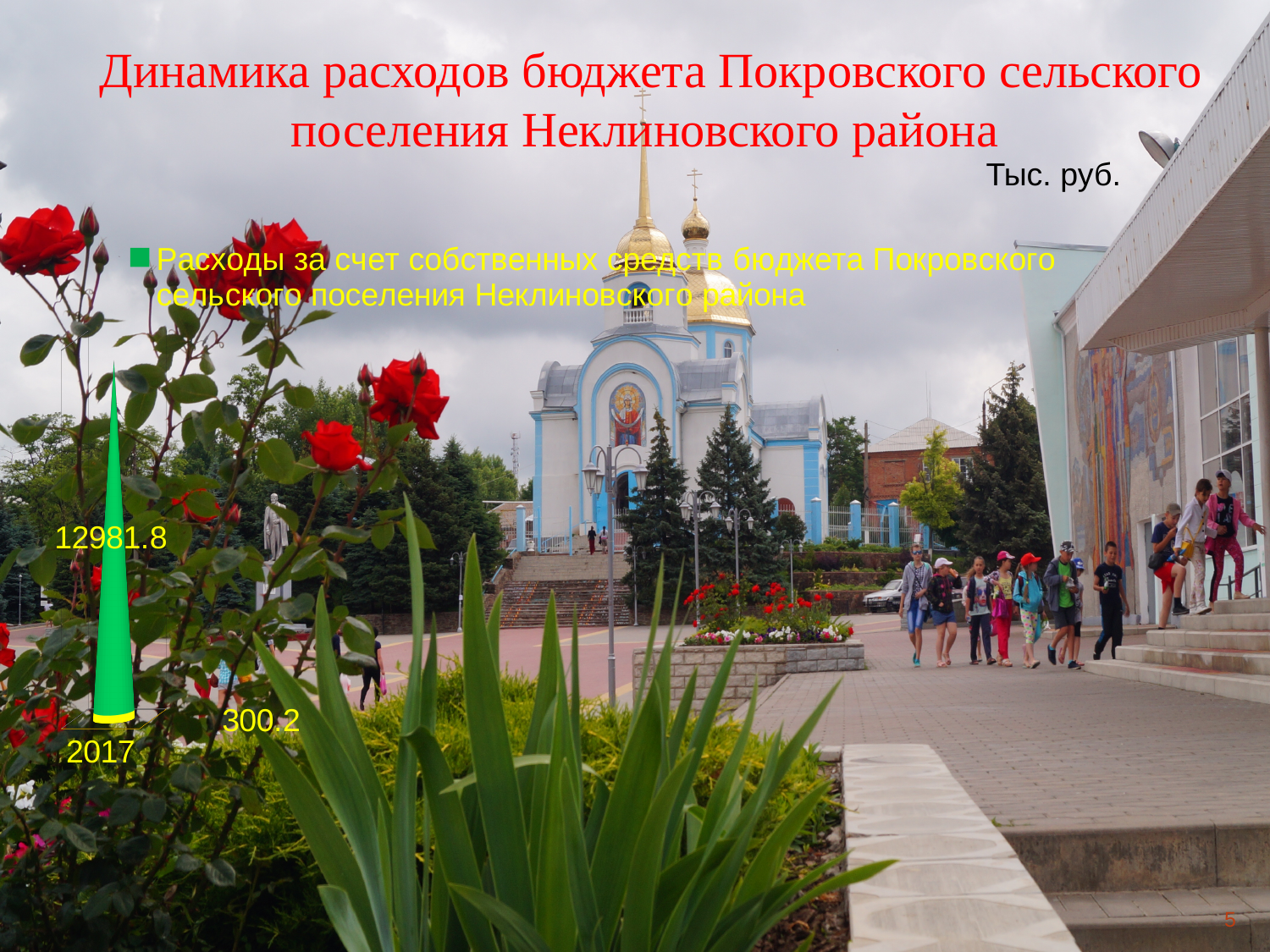
What is the smaller value printed near the base of the 2017 bar? 300.2 Which year is shown on the x axis of the chart? 2017 Which of the two printed values on the chart is larger, 12981.8 or 300.2? 12981.8 What is the difference between the two printed values 12981.8 and 300.2? 12681.6 What unit of measurement is indicated for the chart values? Тыс. руб. How many categories (years) are plotted on the chart? 1 What kind of chart is shown on the slide? Bar chart How many series does the chart legend list? 1 What is the value of the green series (Расходы за счет собственных средств бюджета) for 2017? 12981.8 Is the value 12981.8 for 2017 greater or less than 10000? greater